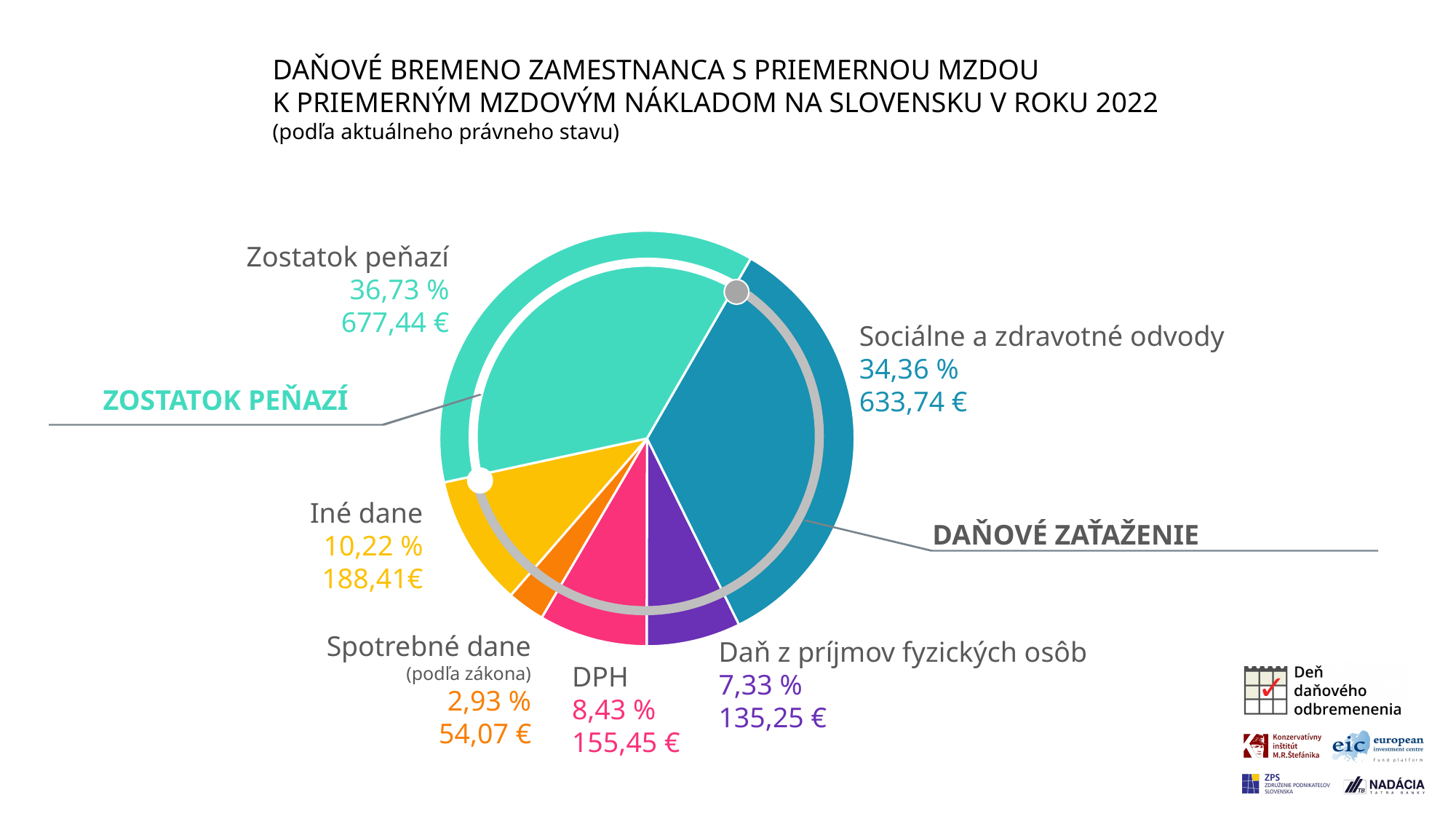
What are the two group labels shown beside the pie chart? ZOSTATOK PEŇAZÍ and DAŇOVÉ ZAŤAŽENIE What kind of chart is shown on the slide? Pie chart Which is larger, the share for DPH or the share for Daň z príjmov fyzických osôb? DPH What euro amount is shown for Sociálne a zdravotné odvody? 633,74 € What euro amount is shown for DPH? 155,45 € What percentage share is shown for Zostatok peňazí? 36,73 % How many slices does the pie chart have? 6 What is the difference in euros between Iné dane and DPH? 32,96 € Which slice of the pie chart is the largest? Zostatok peňazí What is the difference in euros between Zostatok peňazí and Sociálne a zdravotné odvody? 43,70 € Which slice of the pie chart is the smallest? Spotrebné dane What percentage share is shown for Daň z príjmov fyzických osôb? 7,33 %